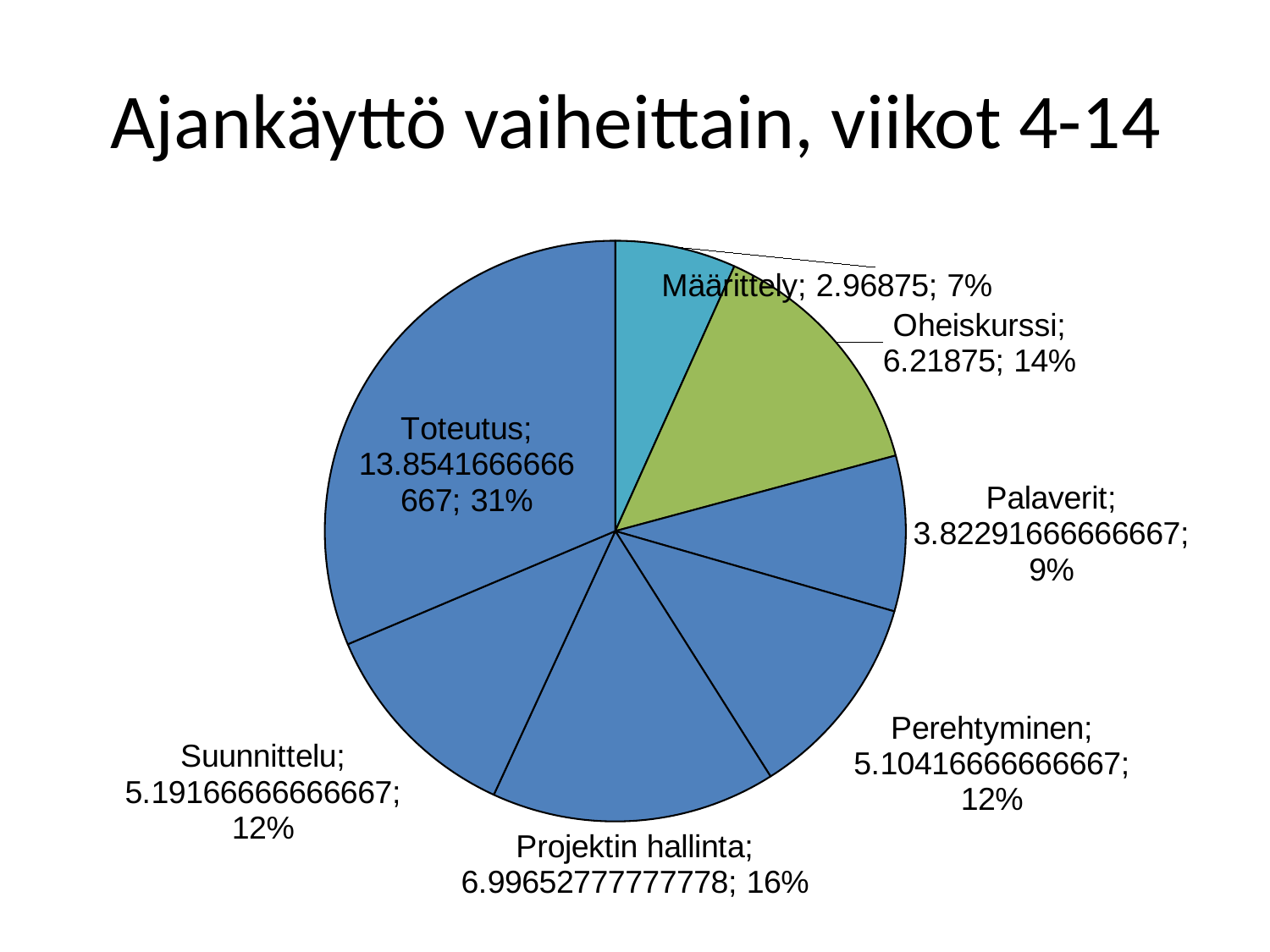
What is the difference between the values for Oheiskurssi and Määrittely? 3.25 What share of the pie does Toteutus represent? 31% Which phase has the smallest slice of the pie? Määrittely What value is shown for Oheiskurssi? 6.21875 What value is shown for Projektin hallinta? 6.99652777777778 How many slices does the pie chart have? 7 What value is shown for Määrittely? 2.96875 Which is larger, the value for Oheiskurssi or the value for Palaverit? Oheiskurssi What type of chart is shown on the slide? pie chart What is the title of the chart? Ajankäyttö vaiheittain, viikot 4-14 What share of the pie does Palaverit represent? 9% Which phase has the largest slice of the pie? Toteutus